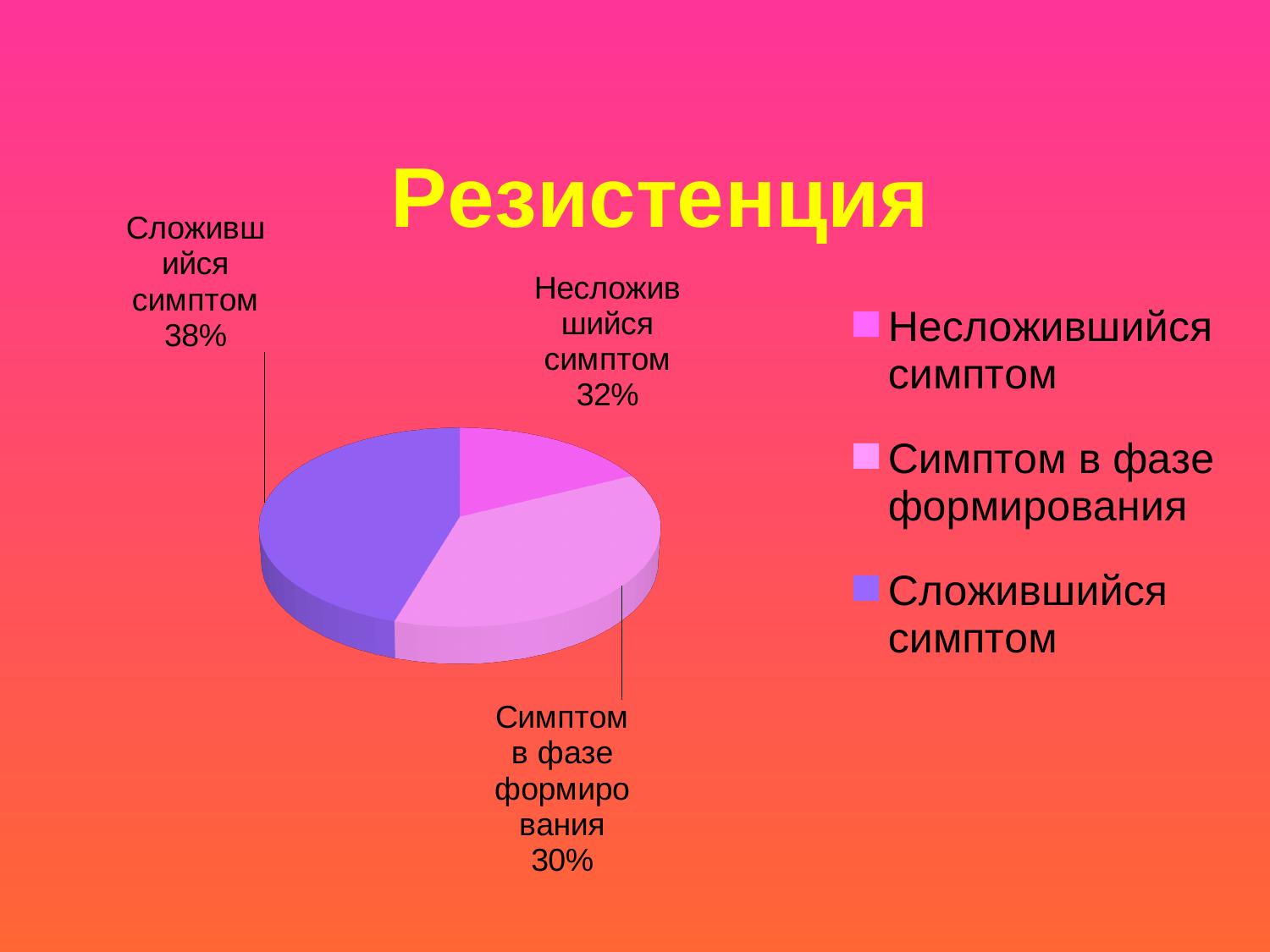
What is the title of the slide with the pie chart? Резистенция What is the share for "Сложившийся симптом"? 38% Which colour represents "Сложившийся симптом" in the legend? purple What is the share for "Несложившийся симптом"? 32% What is the difference in percentage points between "Несложившийся симптом" and "Симптом в фазе формирования"? 2 What is the difference in percentage points between "Сложившийся симптом" and "Симптом в фазе формирования"? 8 What is the share for "Симптом в фазе формирования"? 30% Which category has the largest share of the pie? Сложившийся симптом How many slices does the pie chart have? 3 What kind of chart is shown on the slide? pie chart Which is larger: the share for "Сложившийся симптом" or for "Несложившийся симптом"? Сложившийся симптом